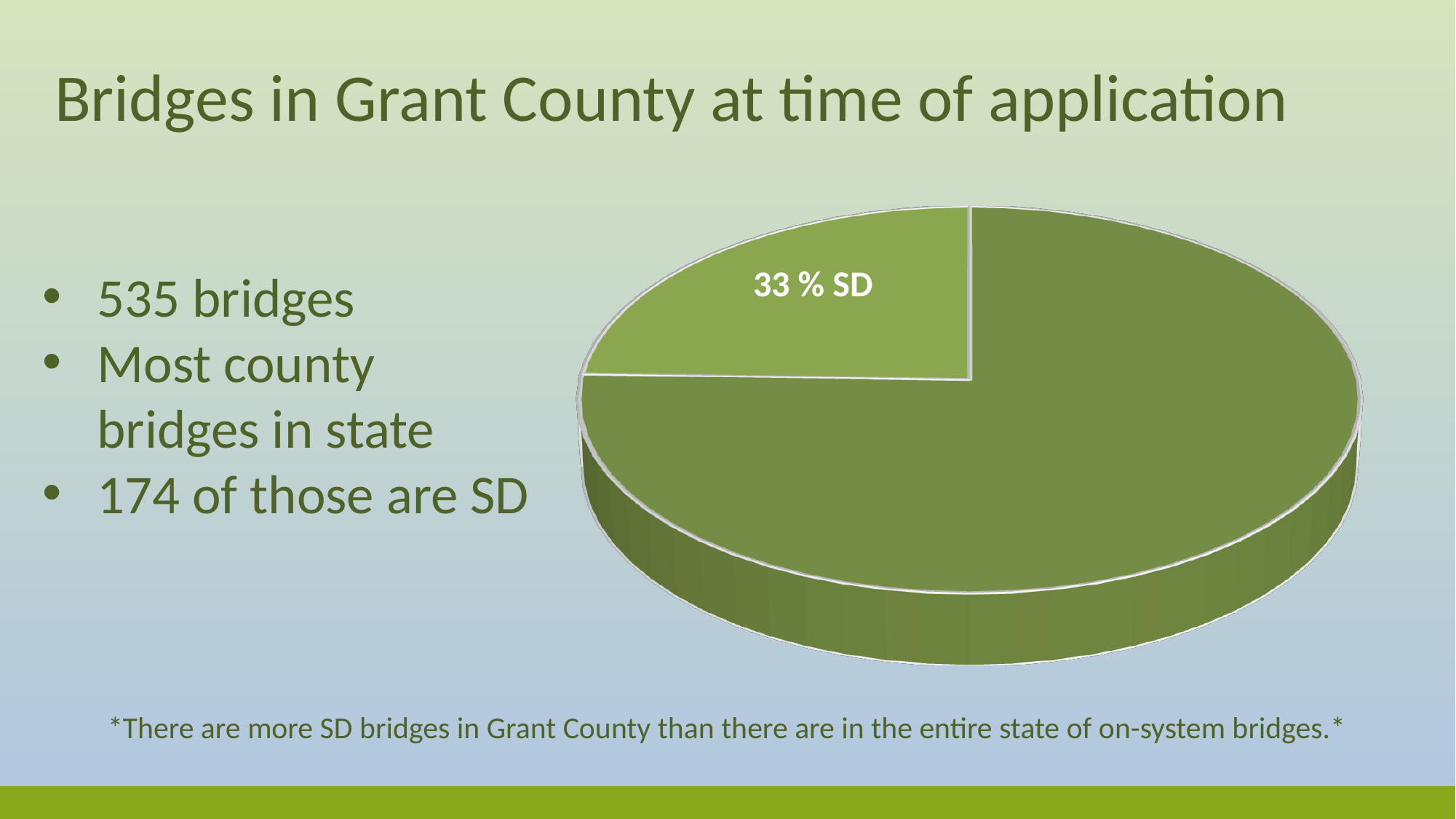
What share of the pie does the SD slice represent? 33 % Is the SD slice a lighter or darker green than the other slice? lighter Which slice of the pie chart is the smallest? 33 % SD Does the pie chart include a legend? No What is the data label printed on the smaller slice of the pie chart? 33 % SD Is the SD slice larger or smaller than the other slice of the pie? smaller What kind of chart is shown on the slide? pie chart Is the SD slice's share of the pie greater or less than 50%? less How many slices does the pie chart have? 2